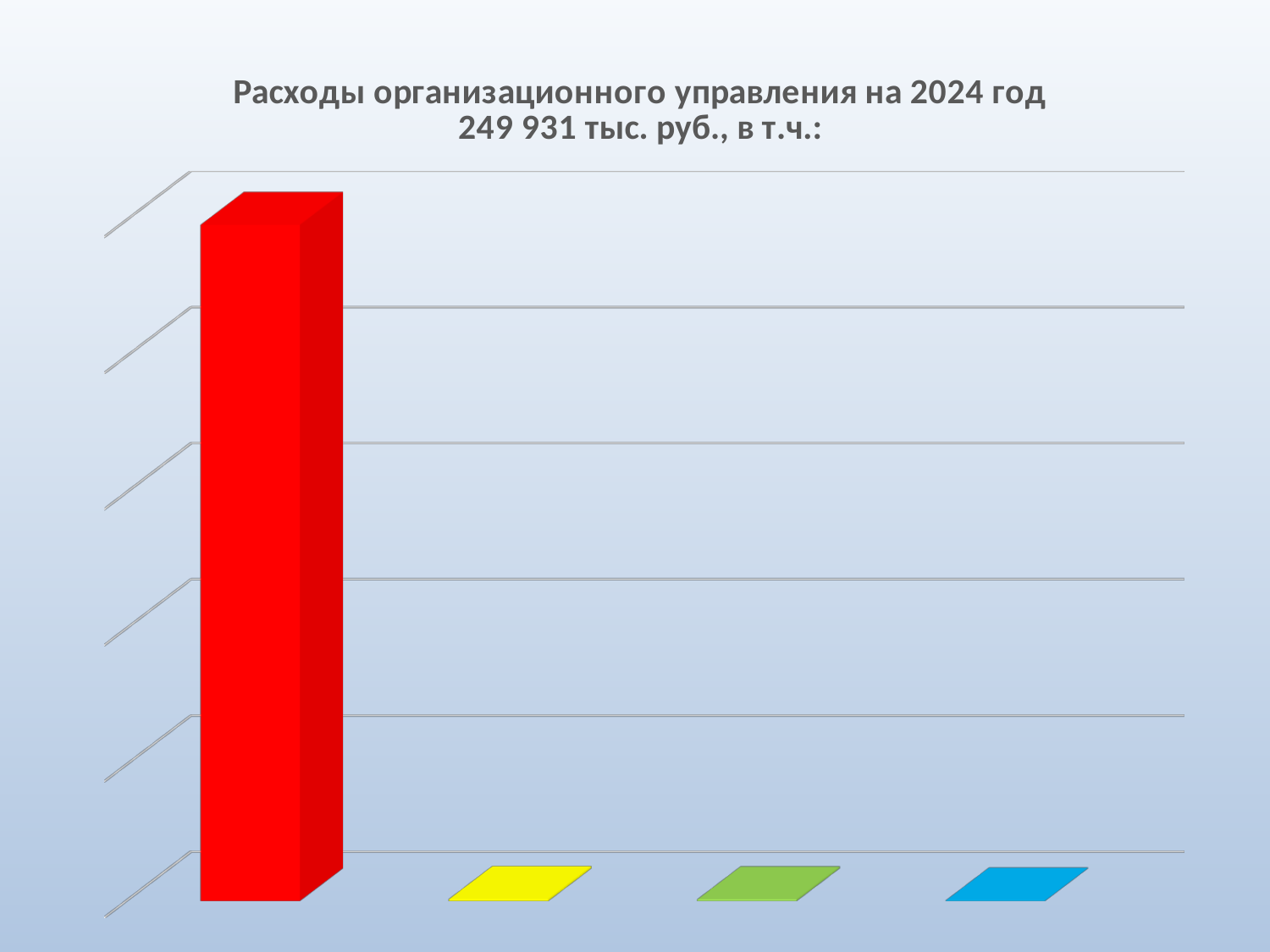
What kind of chart is shown on the slide? bar chart What total amount of expenses for 2024 is stated in the chart title? 249 931 тыс. руб. What is the title of the chart? Расходы организационного управления на 2024 год 249 931 тыс. руб., в т.ч.: Which coloured bar is the tallest in the chart? the red bar Which is larger, the blue bar or the red bar? the red bar How many bars are plotted in the chart? 4 Which is larger, the red bar or the yellow bar? the red bar